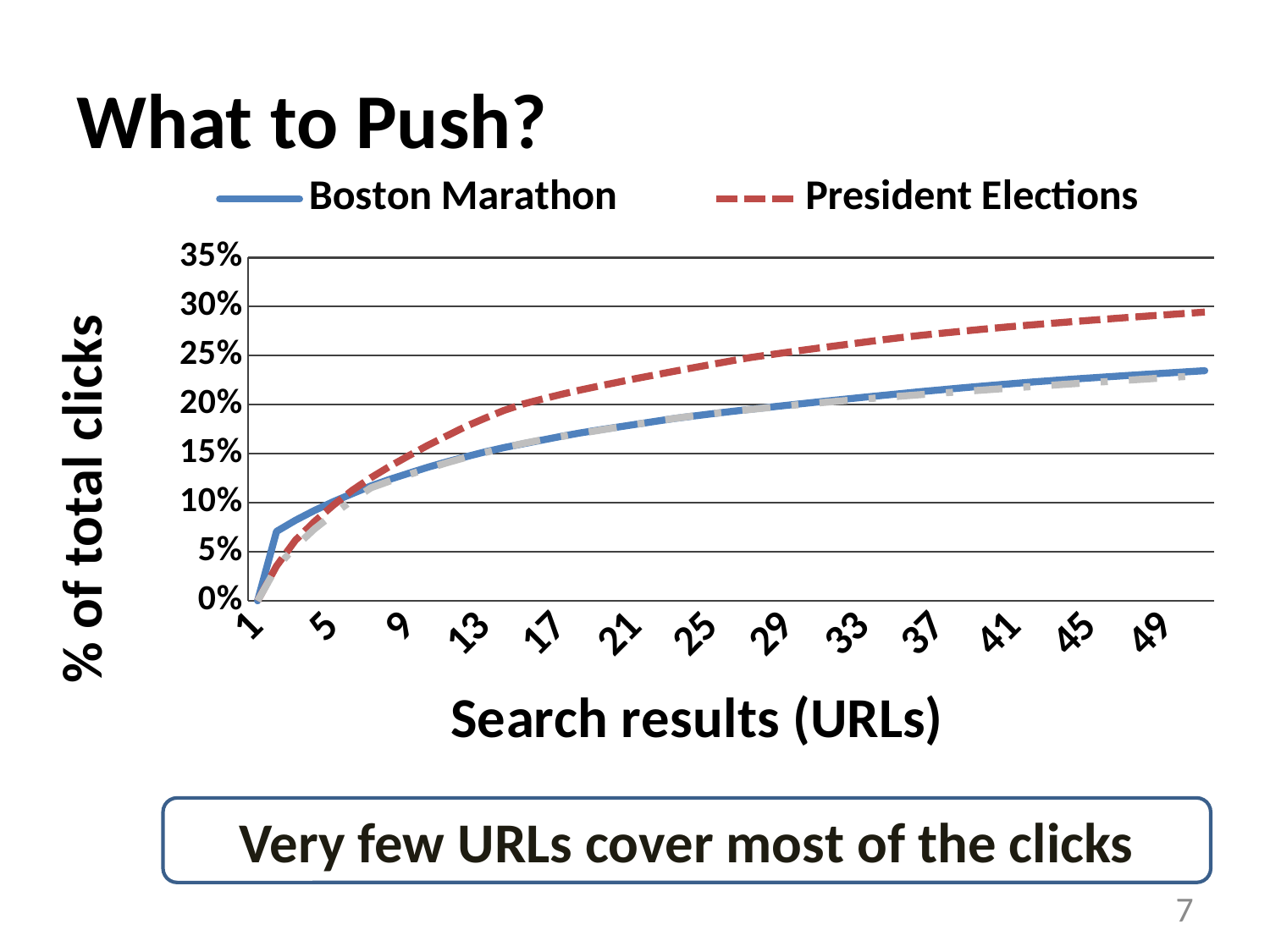
Do the values for President Elections rise or fall as the number of search results increases? rise Is the value for President Elections at search result 49 greater or less than 25%? greater Is the value for Boston Marathon at search result 49 greater or less than 25%? less What are the two series named in the chart legend? Boston Marathon and President Elections At search result 49, which series has the higher % of total clicks, Boston Marathon or President Elections? President Elections Is the value for Boston Marathon at search result 9 greater or less than 10%? greater Do the values for Boston Marathon rise or fall along the x axis? rise How many series does the chart legend list? 2 What is the title of the y axis of the chart? % of total clicks What kind of chart is shown on the slide? line chart